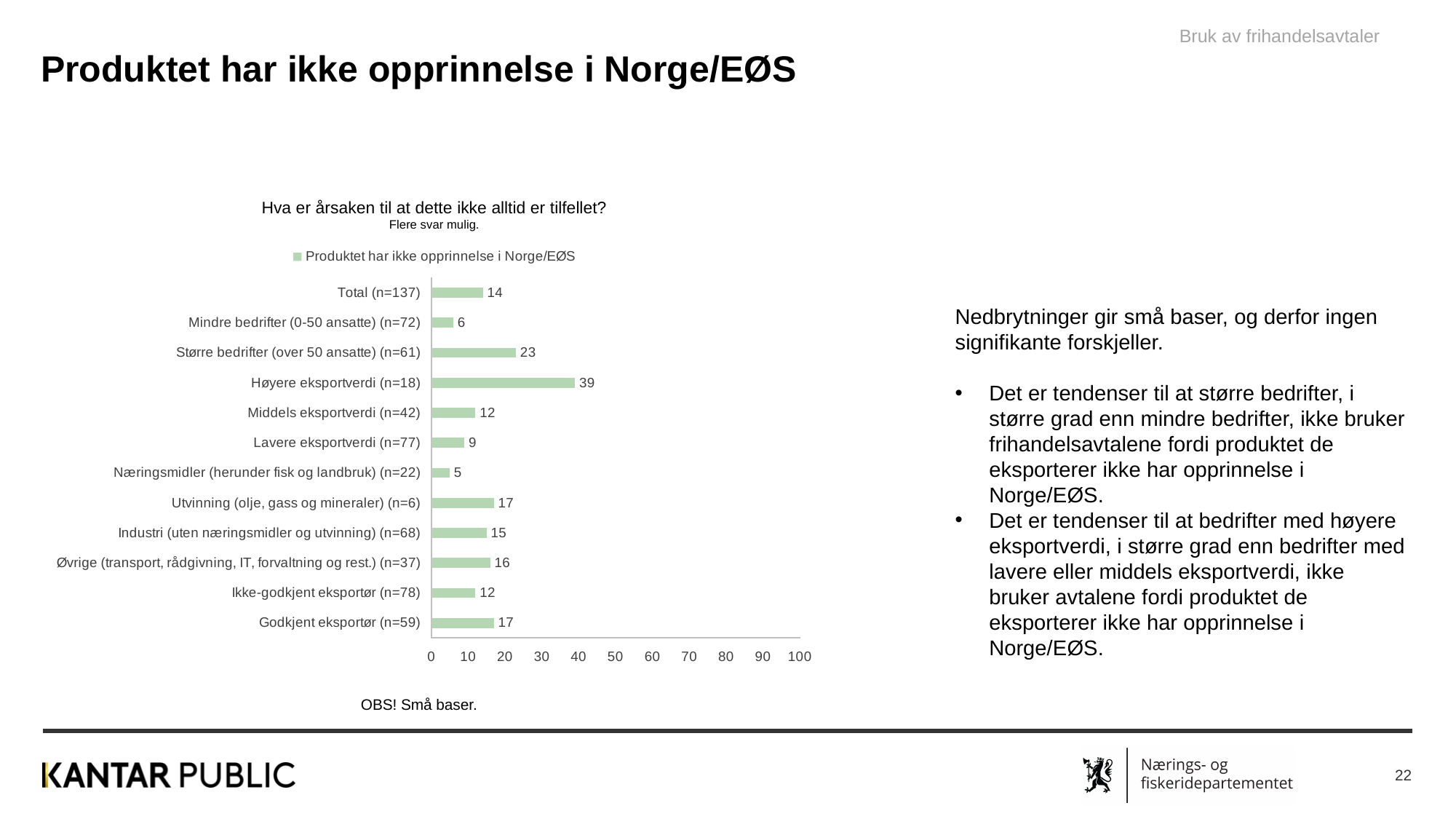
Is the value for Høyere eksportverdi (n=18) greater or less than 30? greater Which is larger, the value for Godkjent eksportør (n=59) or Ikke-godkjent eksportør (n=78)? Godkjent eksportør (n=59) Which category has the highest value? Høyere eksportverdi (n=18) What is the value for Næringsmidler (herunder fisk og landbruk) (n=22)? 5 Which category has the lowest value? Næringsmidler (herunder fisk og landbruk) (n=22) What is the difference between Større bedrifter (over 50 ansatte) (n=61) and Mindre bedrifter (0-50 ansatte) (n=72)? 17 What is the value for Høyere eksportverdi (n=18)? 39 What is the value for Total (n=137)? 14 How many categories are shown in the chart? 12 How many series does the legend list? 1 What kind of chart is shown? bar chart What is the legend entry of the chart? Produktet har ikke opprinnelse i Norge/EØS